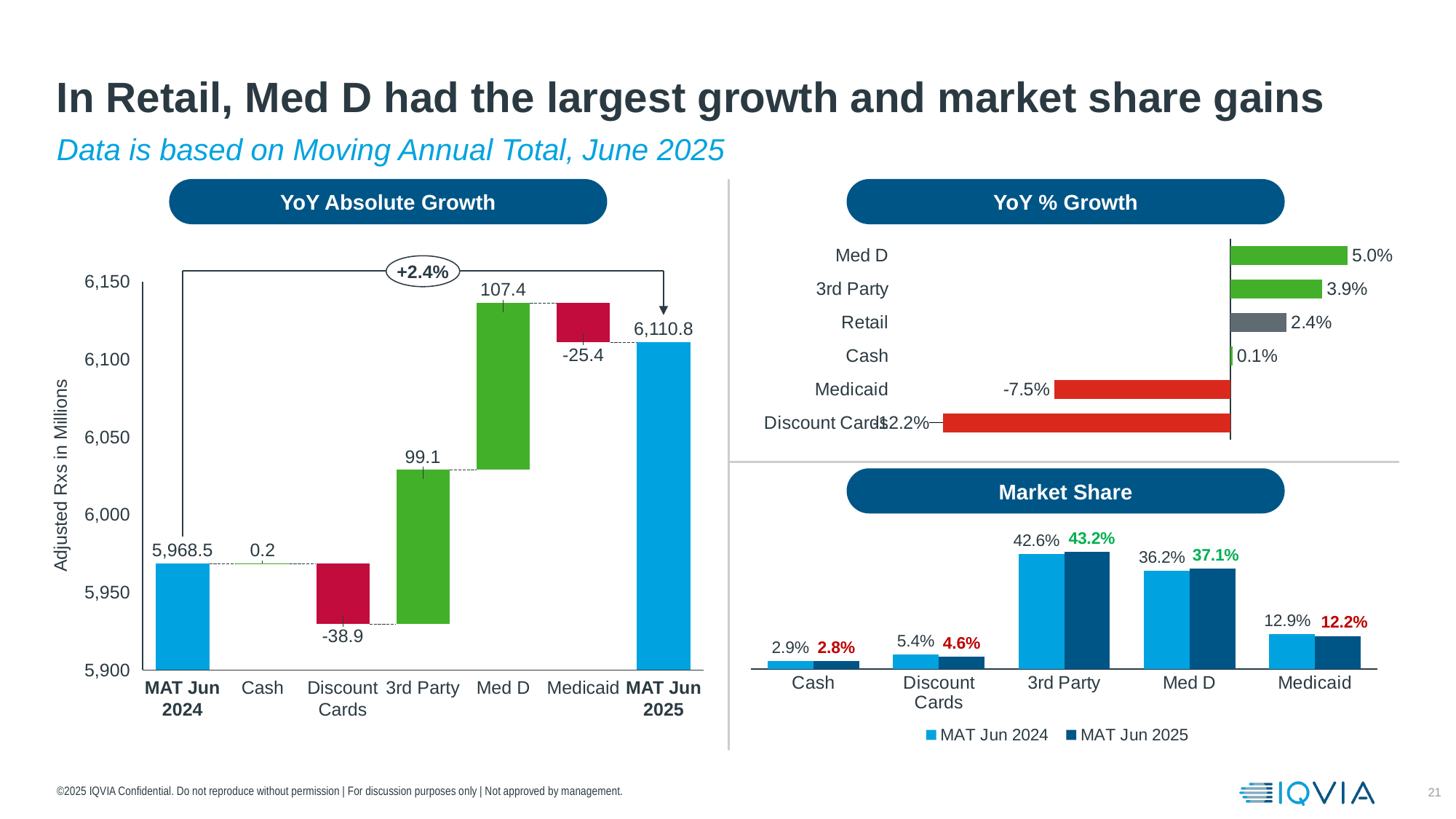
In the YoY Absolute Growth chart, which channel has the largest positive growth? Med D In the Market Share chart, what is the MAT Jun 2025 value for 3rd Party? 43.2% In the YoY % Growth chart, what is the value for 3rd Party? 3.9% In the YoY % Growth chart, what is the value for Medicaid? -7.5% In the Market Share chart, what is the difference between the MAT Jun 2025 and MAT Jun 2024 values for Med D? 0.9% In the Market Share chart, how many series does the legend list? 2 In the Market Share chart, is the MAT Jun 2024 value for Medicaid larger or smaller than the MAT Jun 2025 value? larger In the YoY Absolute Growth chart, what is the value for MAT Jun 2025? 6,110.8 In the YoY Absolute Growth chart, what is the value shown for Med D? 107.4 In the YoY % Growth chart, which category has the lowest value? Discount Cards In the YoY Absolute Growth chart, what is the value shown for Discount Cards? -38.9 In the YoY Absolute Growth chart, what is the difference between the MAT Jun 2025 and MAT Jun 2024 values? 142.3